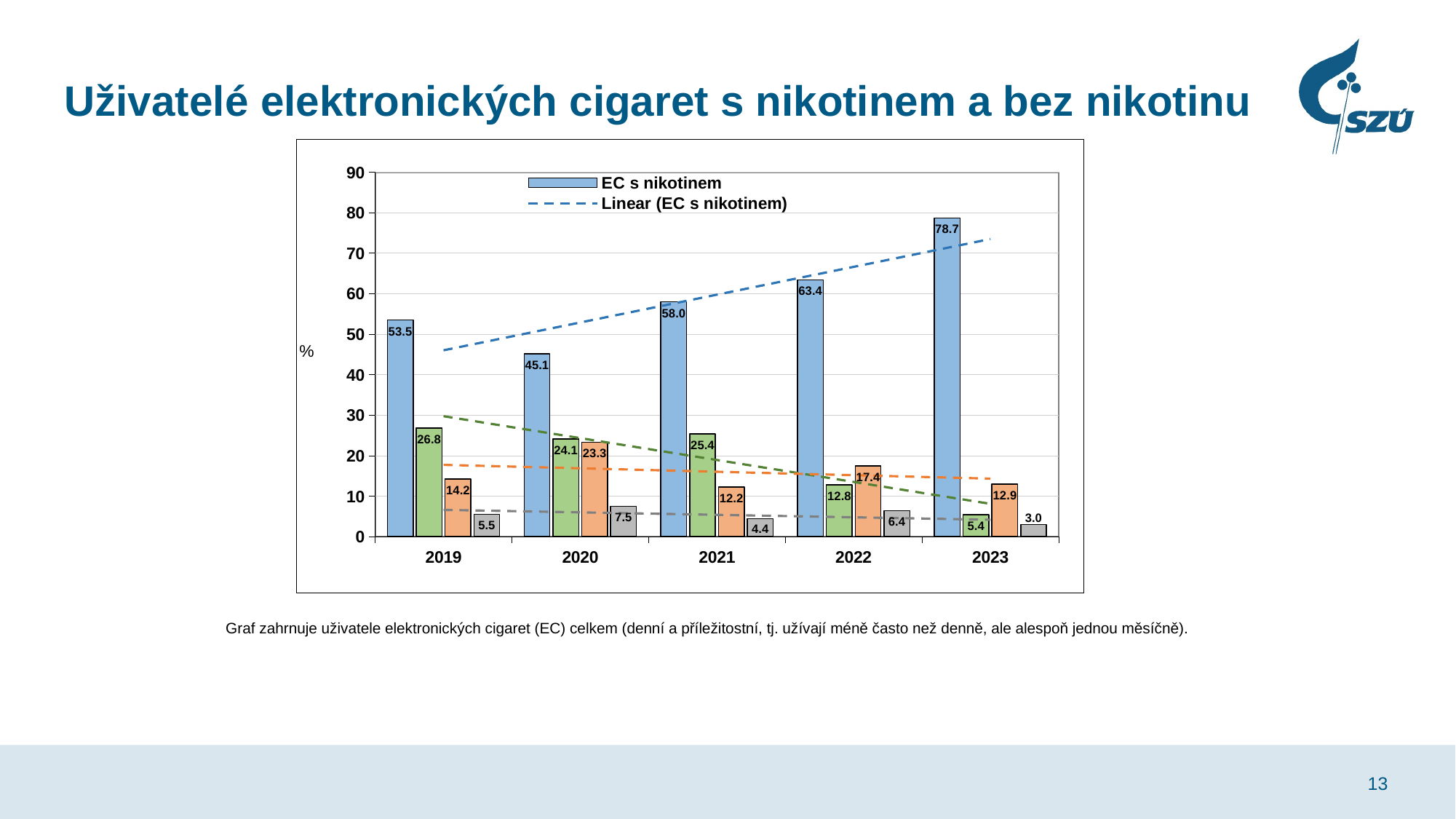
What is the value for EC s nikotinem in 2020? 45.1 Is the value for EC s nikotinem in 2022 greater or less than 60? greater What is the difference between the EC s nikotinem values for 2022 and 2021? 5.4 What is the difference between the EC s nikotinem values for 2023 and 2019? 25.2 In which year is the value for EC s nikotinem lowest? 2020 What is the value for EC s nikotinem in 2019? 53.5 What is the value for EC s nikotinem in 2023? 78.7 Which year has the larger value for EC s nikotinem, 2021 or 2022? 2022 How many years are shown on the x axis? 5 What kind of chart is shown on the slide? bar chart In which year is the value for EC s nikotinem highest? 2023 How many entries does the legend list? 2